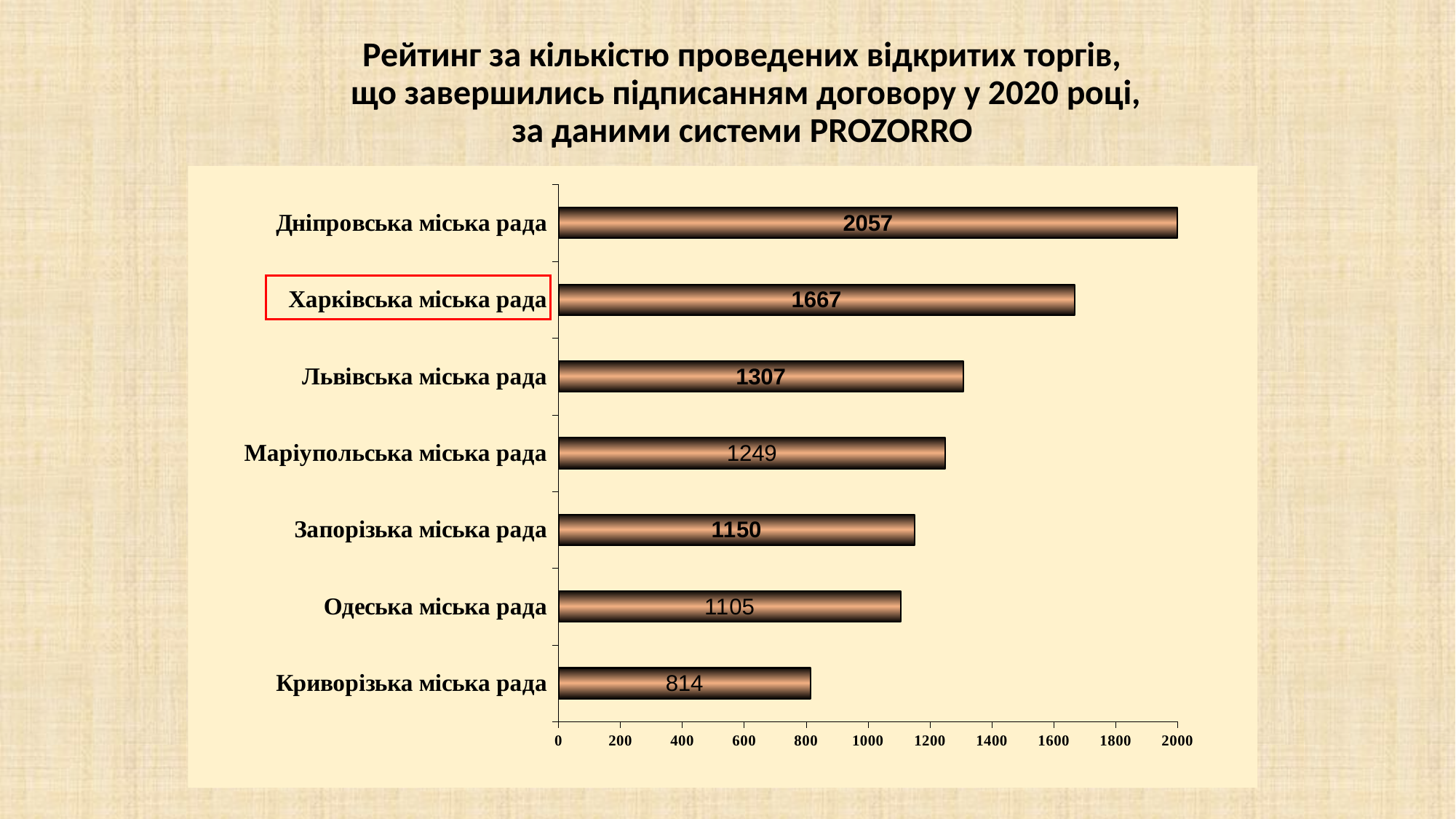
What is the value for Харківська міська рада? 1667 What is the value for Дніпровська міська рада? 2057 Is the value for Криворізька міська рада greater or less than 1000? less What kind of chart is shown on the slide? bar chart What is the difference between the values for Львівська міська рада and Одеська міська рада? 202 Which city council has the highest value? Дніпровська міська рада What is the value for Маріупольська міська рада? 1249 What is the value for Криворізька міська рада? 814 Which city council has the lowest value? Криворізька міська рада How many city councils are shown in the chart? 7 Which is larger, the value for Запорізька міська рада or the value for Одеська міська рада? Запорізька міська рада What is the difference between the values for Дніпровська міська рада and Харківська міська рада? 390